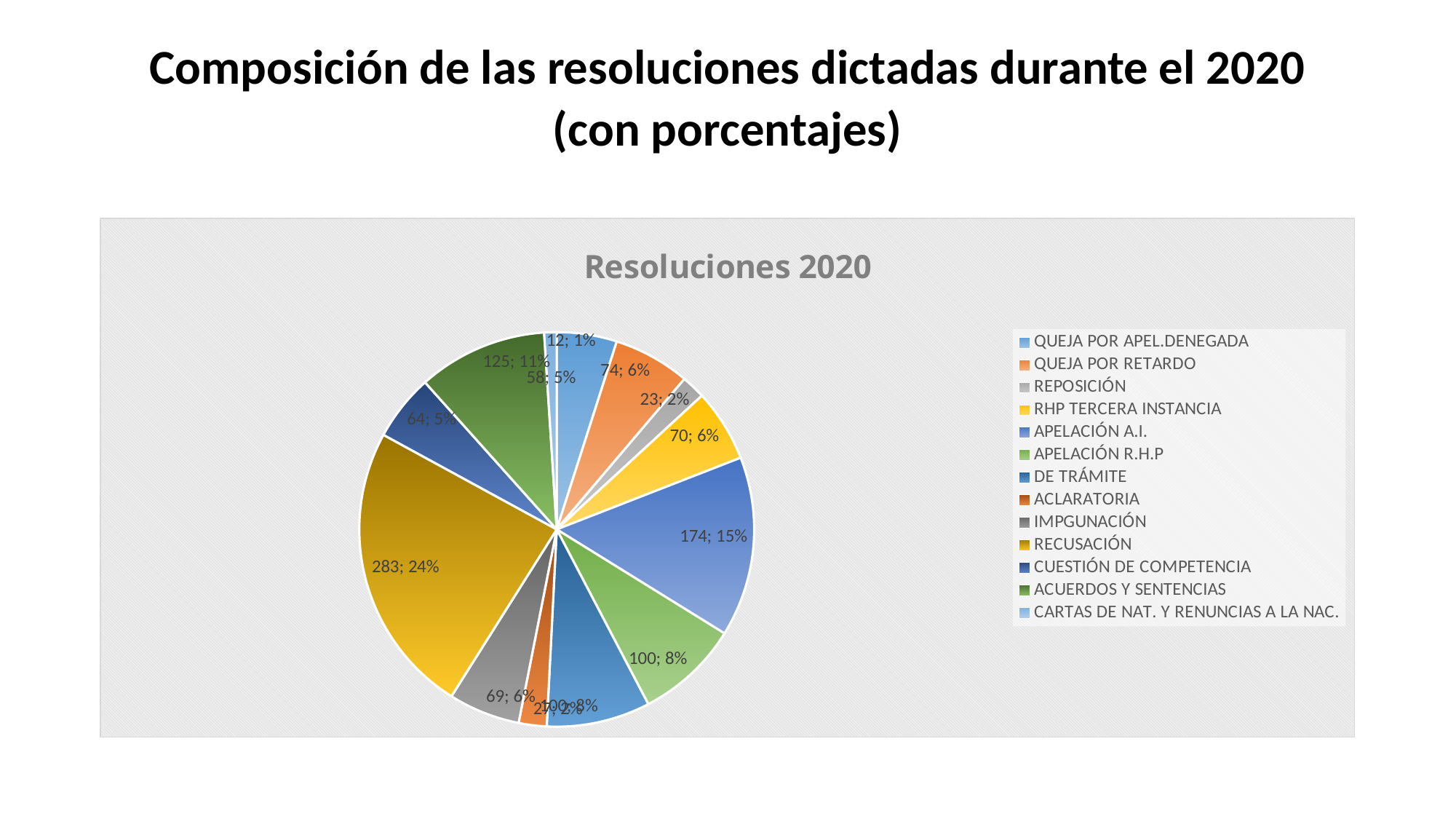
What is the value for REPOSICIÓN? 23 What is the value for RECUSACIÓN? 283 What is the difference between the values for RECUSACIÓN and APELACIÓN A.I.? 109 What is the title of the chart? Resoluciones 2020 What kind of chart is shown on the slide? pie chart How many categories does the legend list? 13 What share of the pie does ACUERDOS Y SENTENCIAS represent? 11% What is the value for APELACIÓN A.I.? 174 Which category has the smallest slice? CARTAS DE NAT. Y RENUNCIAS A LA NAC. Which category has the largest slice? RECUSACIÓN What share of the pie does RECUSACIÓN represent? 24% Which is larger, the value for QUEJA POR RETARDO or the value for RHP TERCERA INSTANCIA? QUEJA POR RETARDO